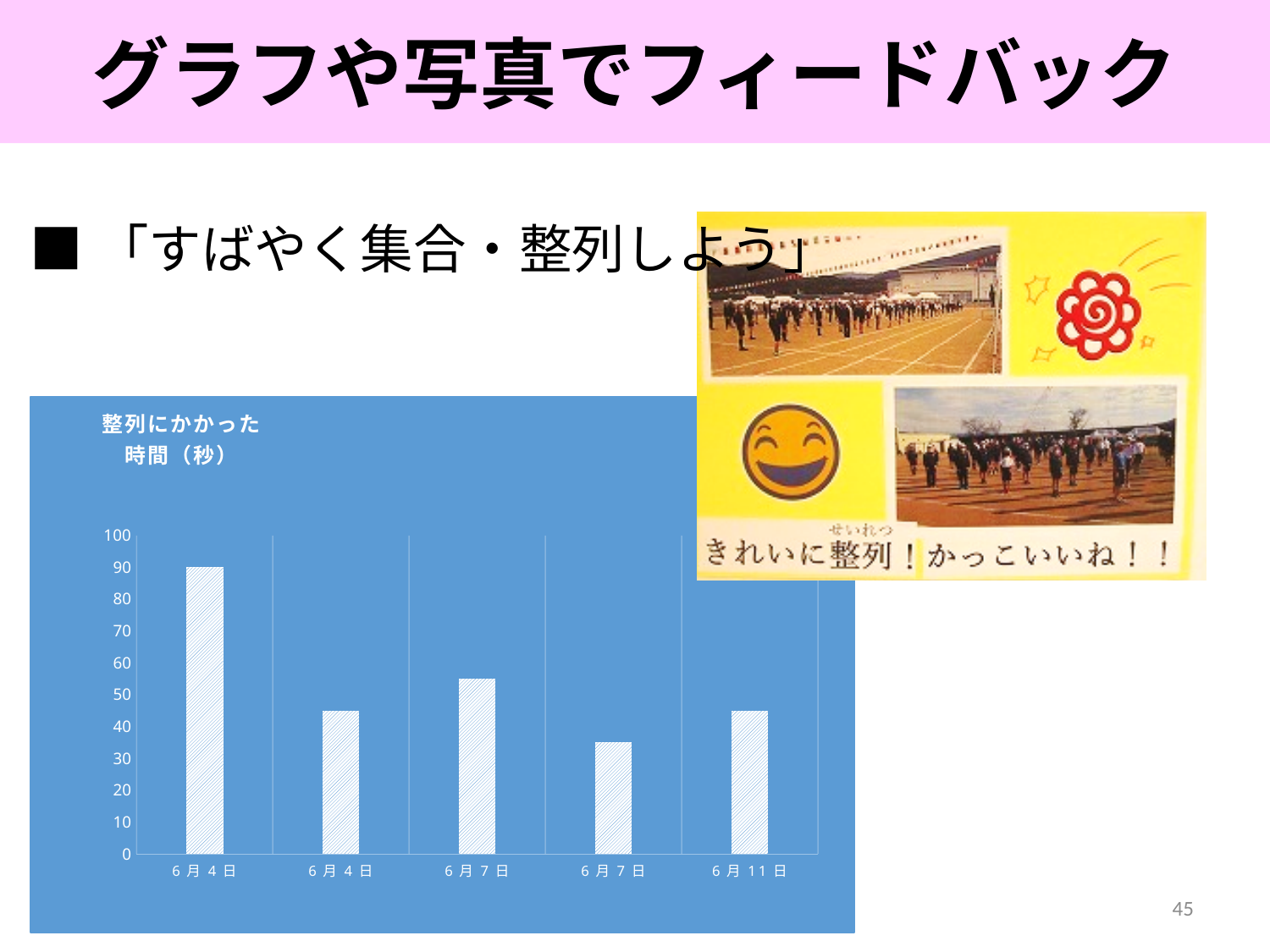
Is the value of the fourth bar (second 6月7日) greater or less than 40? less How many bars are plotted in the chart? 5 Which bar is the lowest in the chart? the fourth bar (second 6月7日) What is the value of the leftmost bar (the first 6月4日)? 90 Is the value for 6月11日 greater or less than 50? less What kind of chart is shown on the slide? bar chart Which is larger: the first 6月7日 bar or the second 6月7日 bar? the first 6月7日 bar Which is larger: the leftmost 6月4日 bar or the 6月11日 bar? the leftmost 6月4日 bar What is the title of the chart? 整列にかかった時間（秒） Is the value of the third bar (first 6月7日) greater or less than 50? greater Which bar is the highest in the chart? the leftmost bar (first 6月4日) What is the highest value shown on the vertical axis? 100